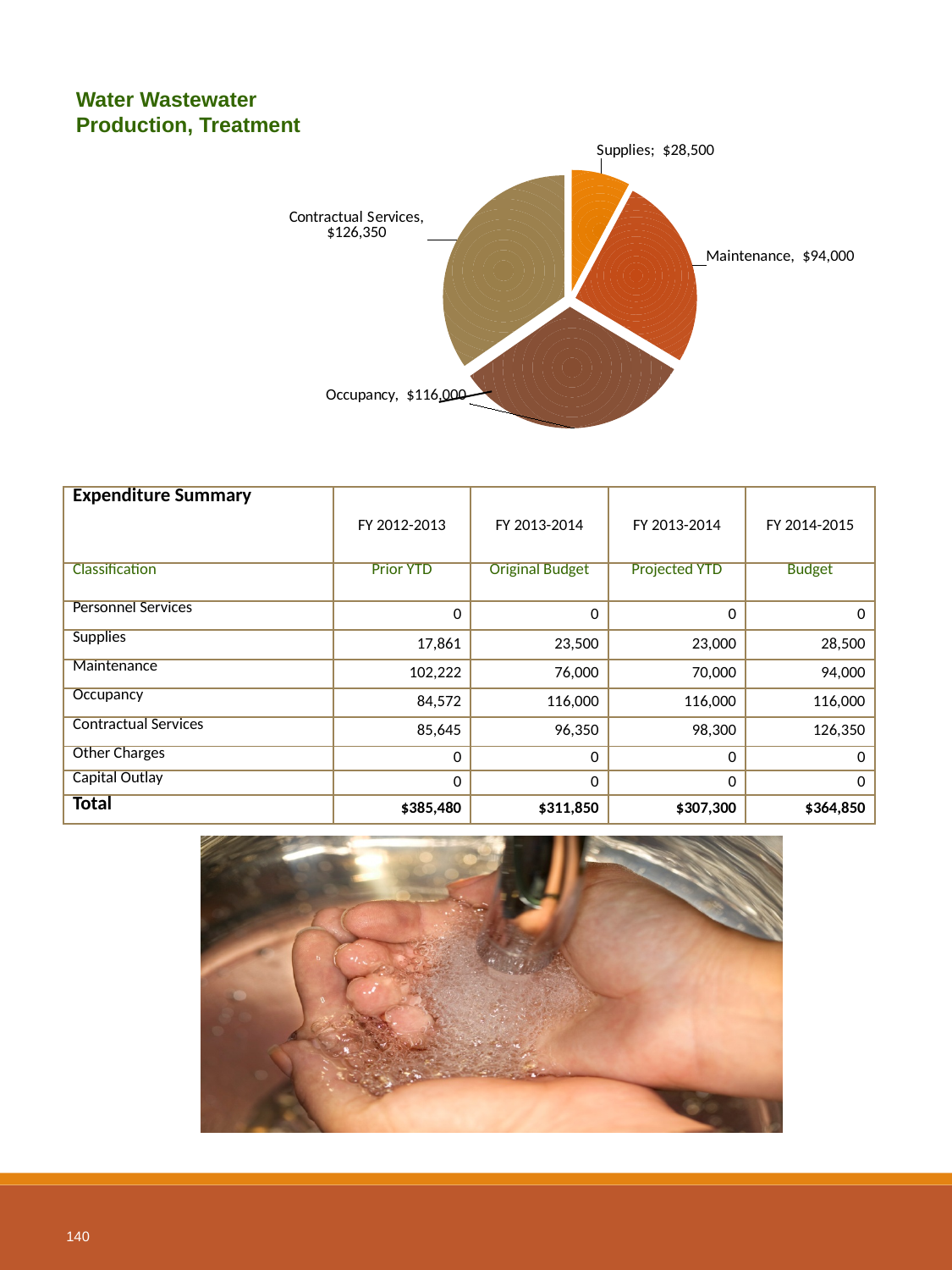
What is the difference between the Contractual Services and Occupancy values in the pie chart? $10,350 Which is larger in the pie chart, Maintenance or Occupancy? Occupancy Which category has the largest slice in the pie chart? Contractual Services Which category has the smallest slice in the pie chart? Supplies What is the value of the Supplies slice in the pie chart? $28,500 What is the value of the Occupancy slice in the pie chart? $116,000 What kind of chart is shown on the slide? pie chart What is the value of the Contractual Services slice in the pie chart? $126,350 What is the title shown above the pie chart? Water Wastewater Production, Treatment What is the value of the Maintenance slice in the pie chart? $94,000 What is the total of all slices in the pie chart? $364,850 How many slices does the pie chart have? 4